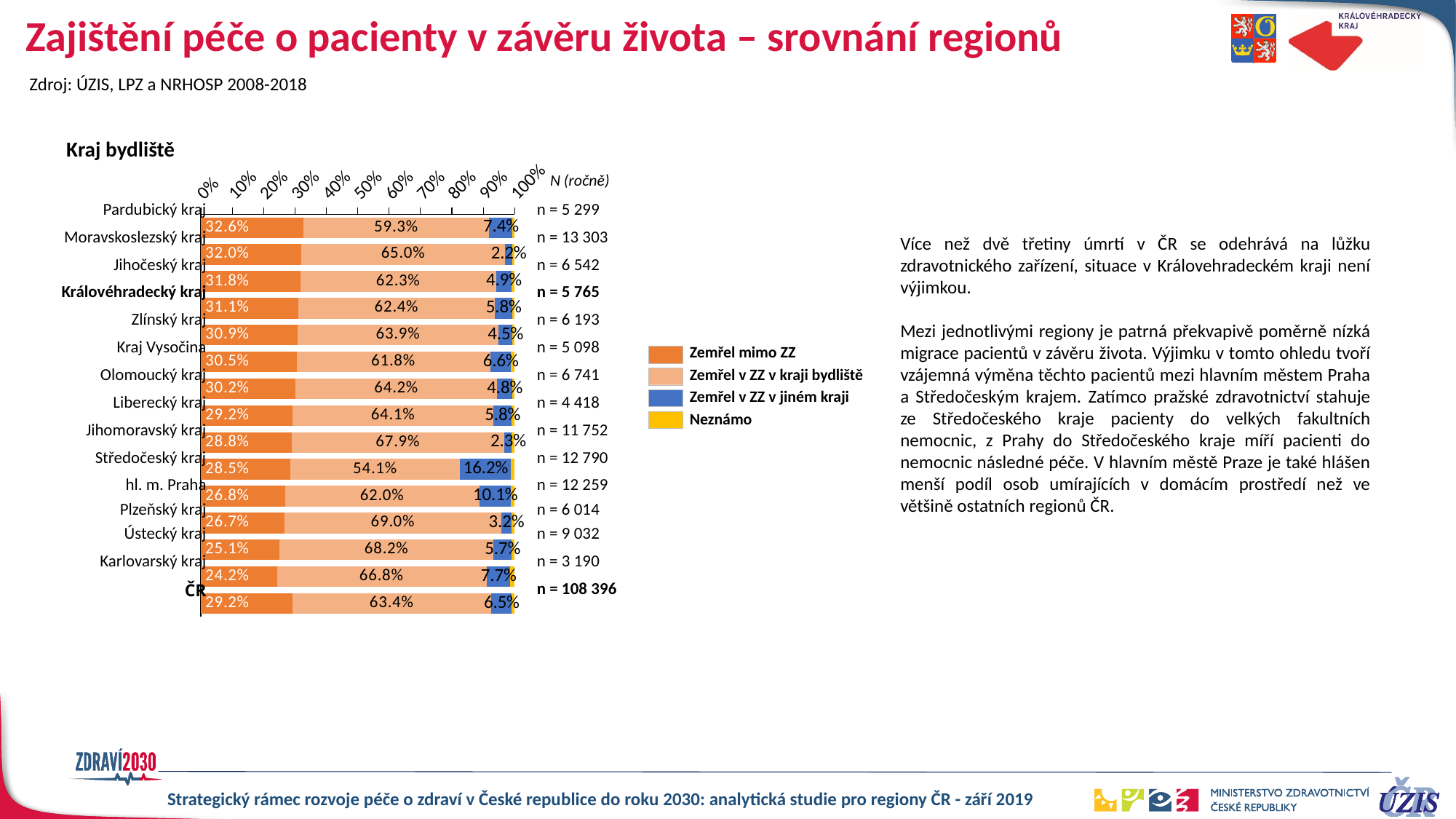
How many categories (rows) are plotted in the chart, including ČR? 15 What percentage of deaths in Pardubický kraj occurred outside a healthcare facility (Zemřel mimo ZZ)? 32.6% What is the 'Zemřel v ZZ v kraji bydliště' value for Plzeňský kraj? 69.0% What is the share of 'Zemřel v ZZ v jiném kraji' for Středočeský kraj? 16.2% Which has a larger 'Zemřel v ZZ v jiném kraji' share: hl. m. Praha or Moravskoslezský kraj? hl. m. Praha Which region has the lowest share of 'Zemřel mimo ZZ'? Karlovarský kraj What is the difference in 'Zemřel mimo ZZ' between Pardubický kraj (32.6%) and Karlovarský kraj (24.2%)? 8.4 percentage points Which region has the highest share of 'Zemřel mimo ZZ'? Pardubický kraj How many series does the legend list? 4 What type of chart is shown on the slide? Stacked bar chart Which region has the highest share of 'Zemřel v ZZ v jiném kraji'? Středočeský kraj What is the annual N value shown for ČR? n = 108 396